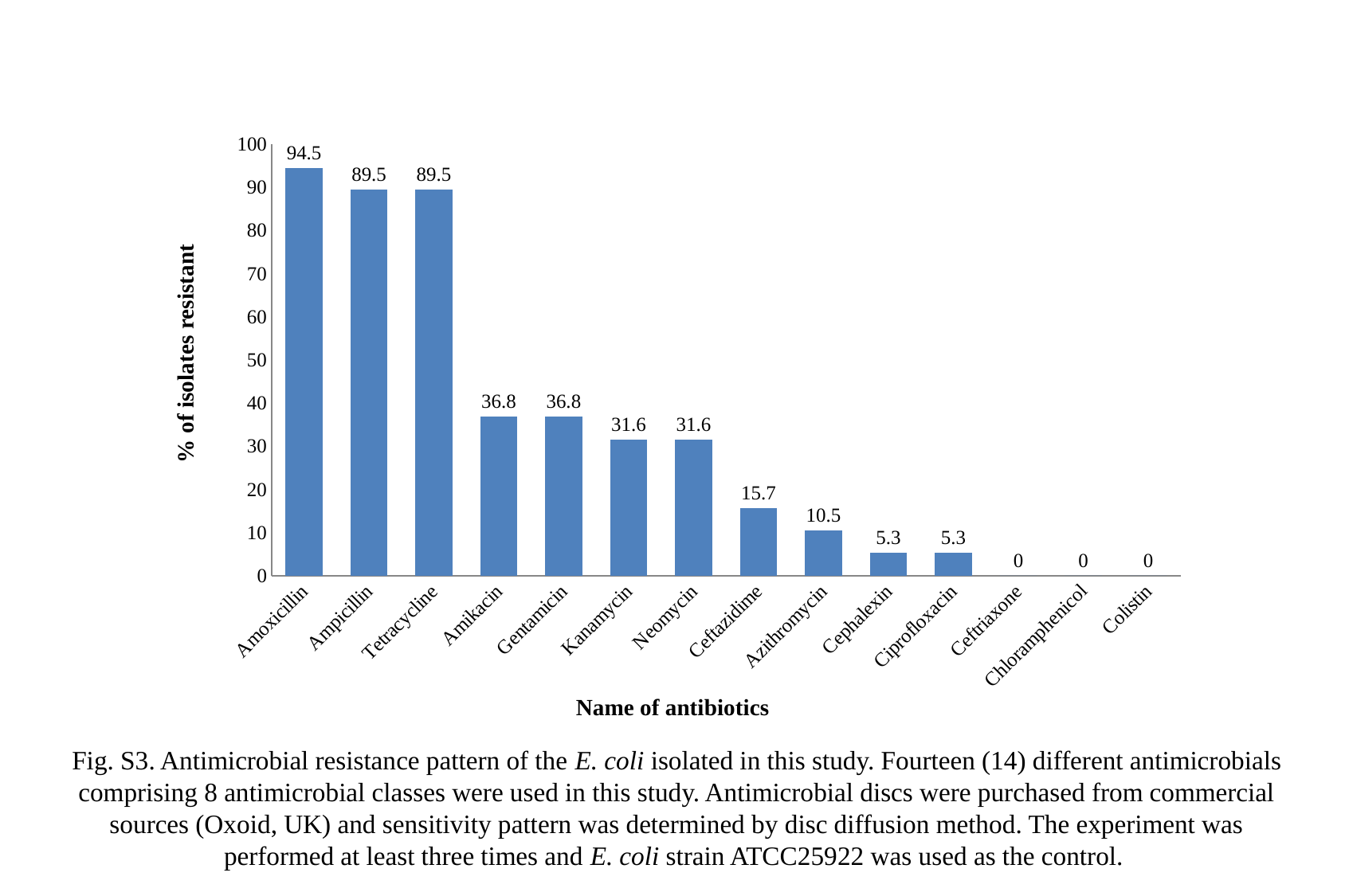
How many antibiotics are shown on the x axis? 14 What is the label of the y axis? % of isolates resistant What is the difference between the resistance percentages for Amoxicillin and Ampicillin? 5 Is the value for Neomycin greater or less than 40? less What is the percentage of isolates resistant to Ceftazidime? 15.7 What is the percentage of isolates resistant to Azithromycin? 10.5 What is the difference between the resistance percentages for Amikacin and Kanamycin? 5.2 Which has a higher percentage of resistant isolates, Tetracycline or Gentamicin? Tetracycline Which antibiotic has the highest percentage of resistant isolates? Amoxicillin What kind of chart is shown on the slide? bar chart How many antibiotics have a resistance value of 0? 3 What is the percentage of isolates resistant to Amoxicillin? 94.5